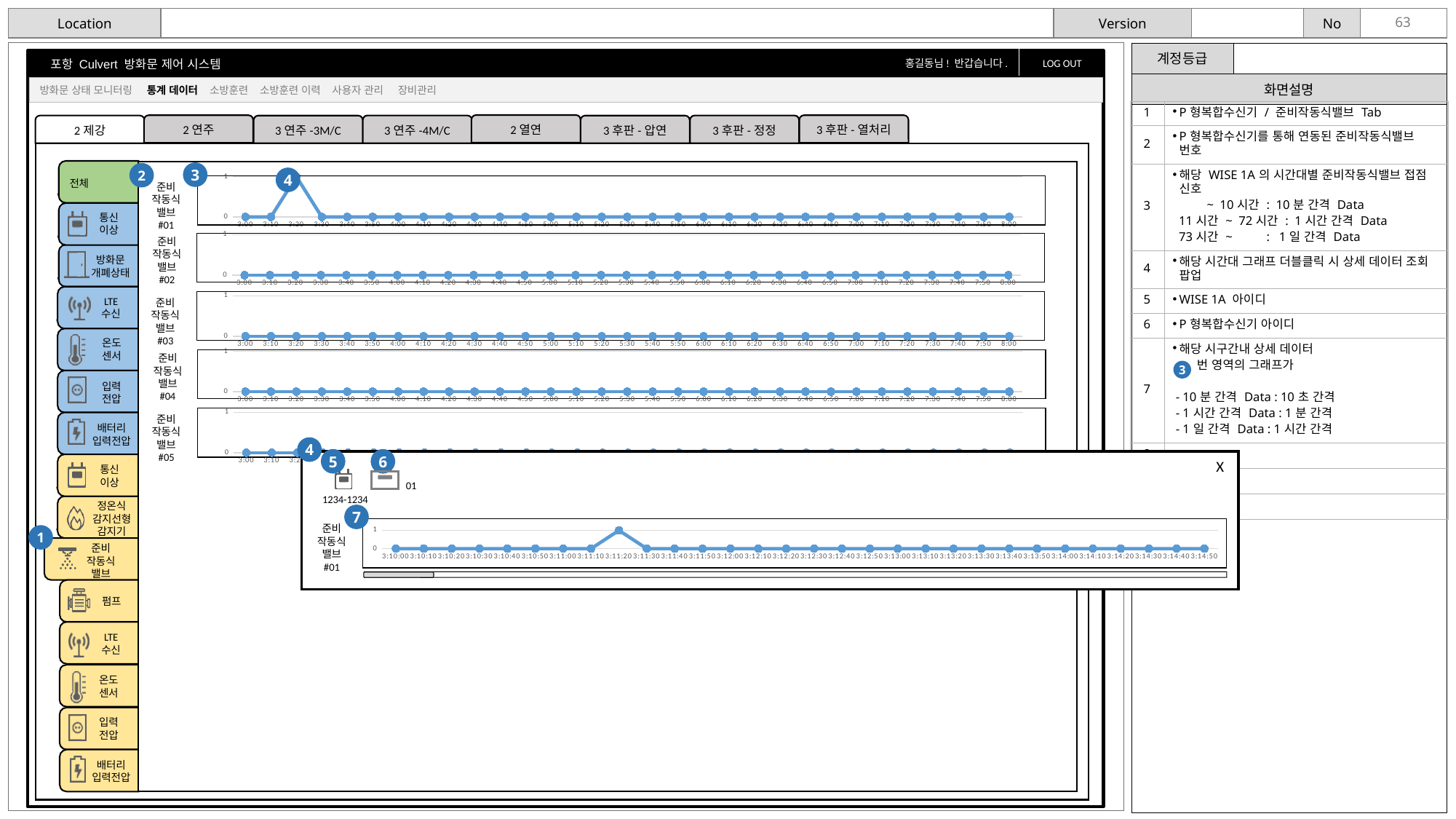
In the 준비작동식밸브 #01 chart in the main panel, which is larger, the value at 3:20 or the value at 3:30? 3:20 In the 준비작동식밸브 #02 chart in the main panel, what is the value at 3:00? 0 In the 준비작동식밸브 #01 chart in the main panel, what is the difference between the value at 3:20 and the value at 3:10? 1 What kind of chart is used for 준비작동식밸브 #01 in the main panel? line chart What is the highest tick shown on the y axis of the popup chart at the bottom? 1 Which valve is the popup chart at the bottom labelled as showing? 준비작동식밸브 #01 In the 준비작동식밸브 #01 chart in the main panel, what is the value at 3:20? 1 In the 준비작동식밸브 #01 chart in the main panel, at which time is the value highest? 3:20 In the 준비작동식밸브 #01 chart in the main panel, what is the value at 3:00? 0 In the popup chart at the bottom, what is the value at 3:10:00? 0 In the popup chart at the bottom, at which time does the line reach its peak? 3:11:20 How many 준비작동식밸브 line charts are stacked in the main panel (excluding the popup)? 5